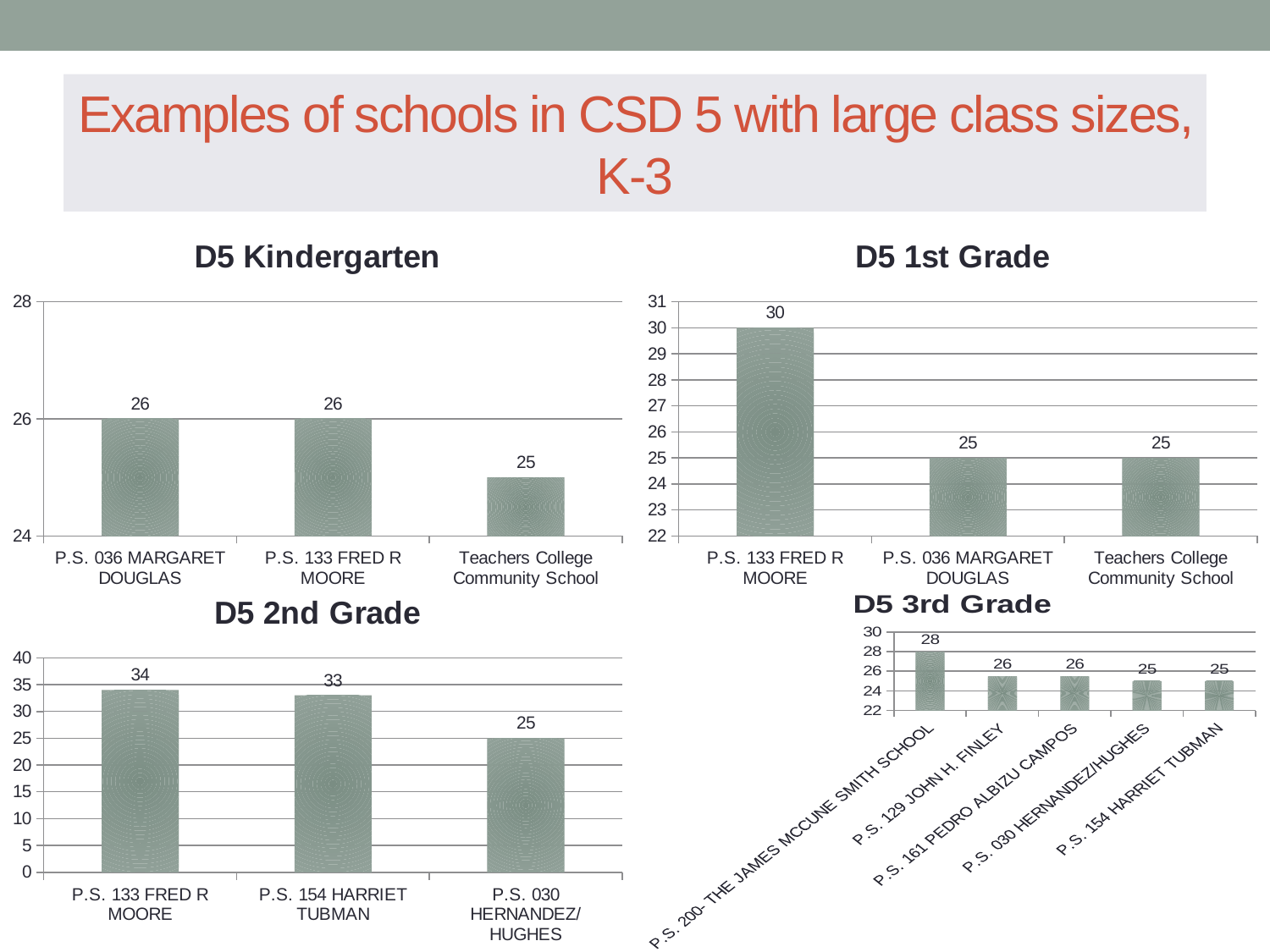
In the D5 2nd Grade chart, what is the difference between P.S. 133 FRED R MOORE and P.S. 030 HERNANDEZ/HUGHES? 9 In the D5 3rd Grade chart, how many schools are shown? 5 In the D5 Kindergarten chart, what is the value for Teachers College Community School? 25 In the D5 1st Grade chart, which school has the highest value? P.S. 133 FRED R MOORE In the D5 3rd Grade chart, do the values rise or fall from left to right? Fall What kind of chart is the D5 Kindergarten chart? Bar chart How many charts are on the slide? 4 In the D5 1st Grade chart, what is the value for P.S. 133 FRED R MOORE? 30 In the D5 2nd Grade chart, which school has the lowest value? P.S. 030 HERNANDEZ/HUGHES In the D5 3rd Grade chart, what is the value for P.S. 200- THE JAMES MCCUNE SMITH SCHOOL? 28 In the D5 1st Grade chart, what is the difference between P.S. 133 FRED R MOORE and Teachers College Community School? 5 In the D5 2nd Grade chart, which is larger, the value for P.S. 133 FRED R MOORE or P.S. 154 HARRIET TUBMAN? P.S. 133 FRED R MOORE